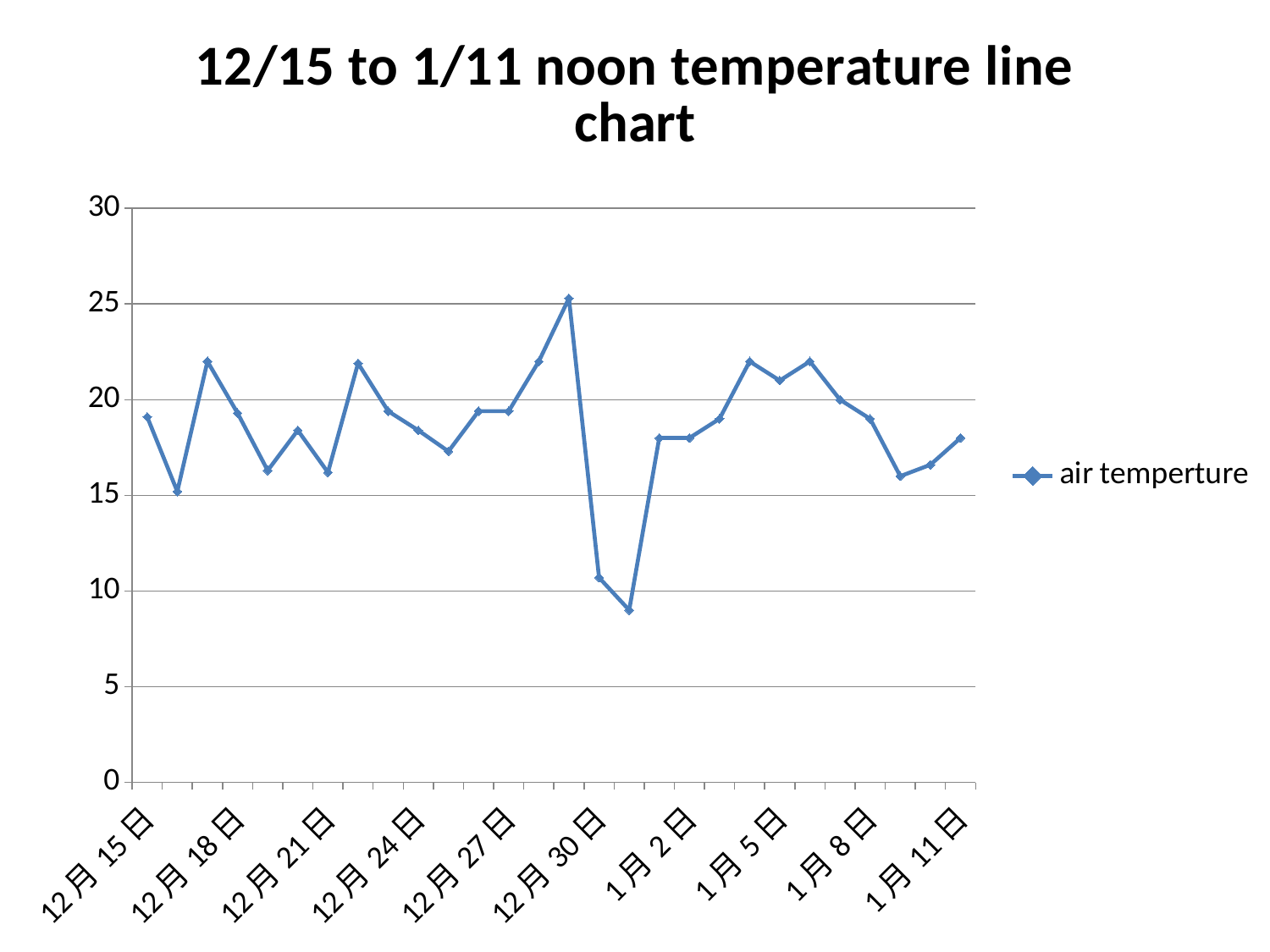
Which has the higher value, 12月30日 or 1月5日? 1月5日 Is the value for 1月5日 greater or less than 20? greater What kind of chart is shown on the slide? line chart Does the line rise or fall from 12月30日 to 1月2日? rise What is the title of the chart? 12/15 to 1/11 noon temperature line chart Is the value for 12月15日 greater or less than 15? greater What is the name of the series shown in the legend? air temperture Is the value for 12月30日 greater or less than 10? greater Which has the lower value, 12月15日 or 12月30日? 12月30日 How many series does the legend list? 1